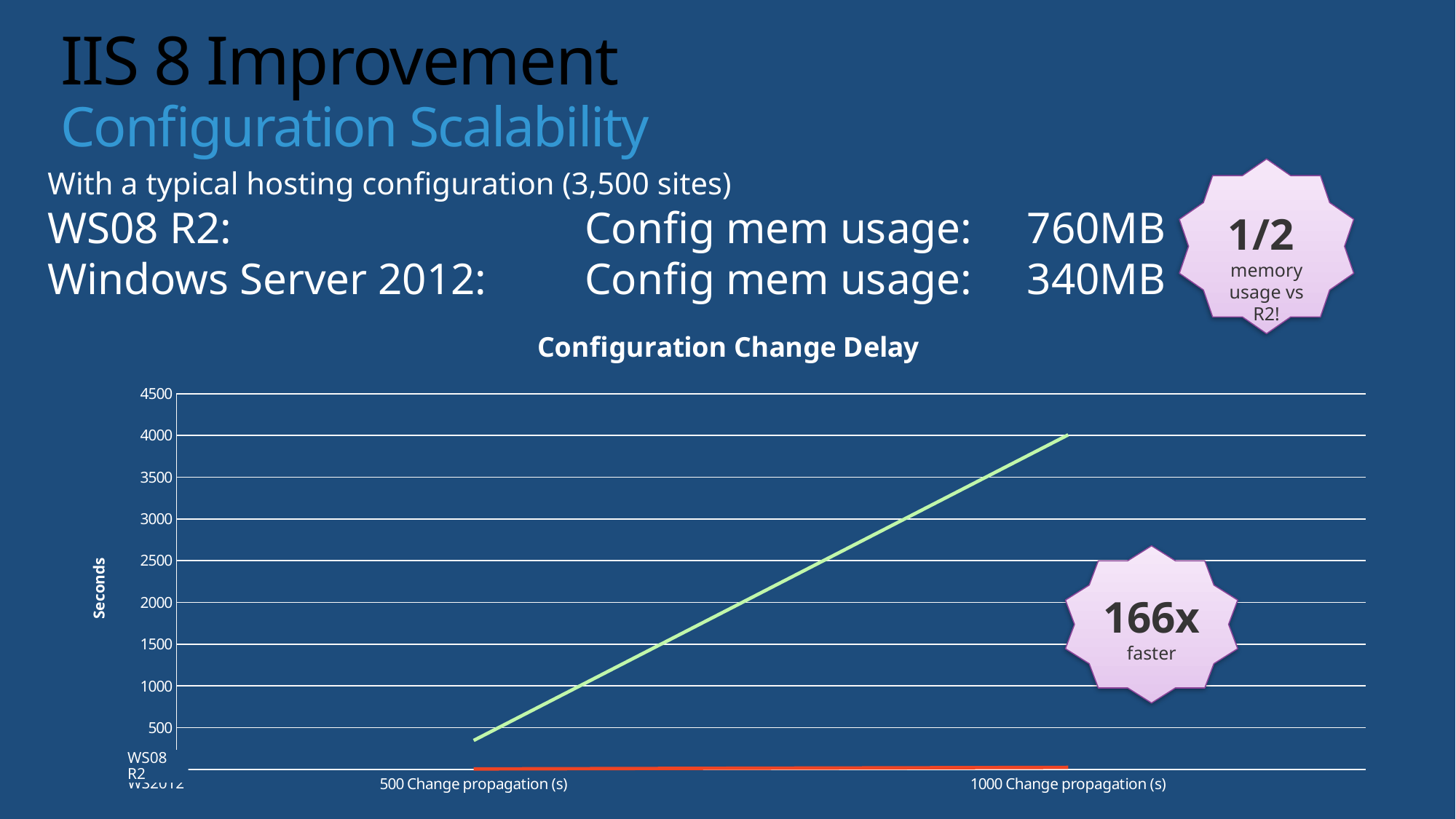
What is the title of the chart on the slide? Configuration Change Delay In the Configuration Change Delay chart, which series has the higher value at 1000 Change propagation (s), WS08 R2 or WS2012? WS08 R2 What is the highest tick value shown on the vertical axis of the Configuration Change Delay chart? 4500 In the Configuration Change Delay chart, does the WS08 R2 line rise or fall from 500 to 1000 Change propagation (s)? rise What kind of chart is the Configuration Change Delay chart? line chart In the Configuration Change Delay chart, is the WS08 R2 value at 500 Change propagation (s) greater or less than 500? less In the Configuration Change Delay chart, is the WS08 R2 value at 1000 Change propagation (s) greater or less than 3500? greater In the Configuration Change Delay chart, is the WS2012 (red line) value at 1000 Change propagation (s) greater or less than 500? less How many categories are shown on the x axis of the Configuration Change Delay chart? 2 What is the label on the vertical axis of the Configuration Change Delay chart? Seconds